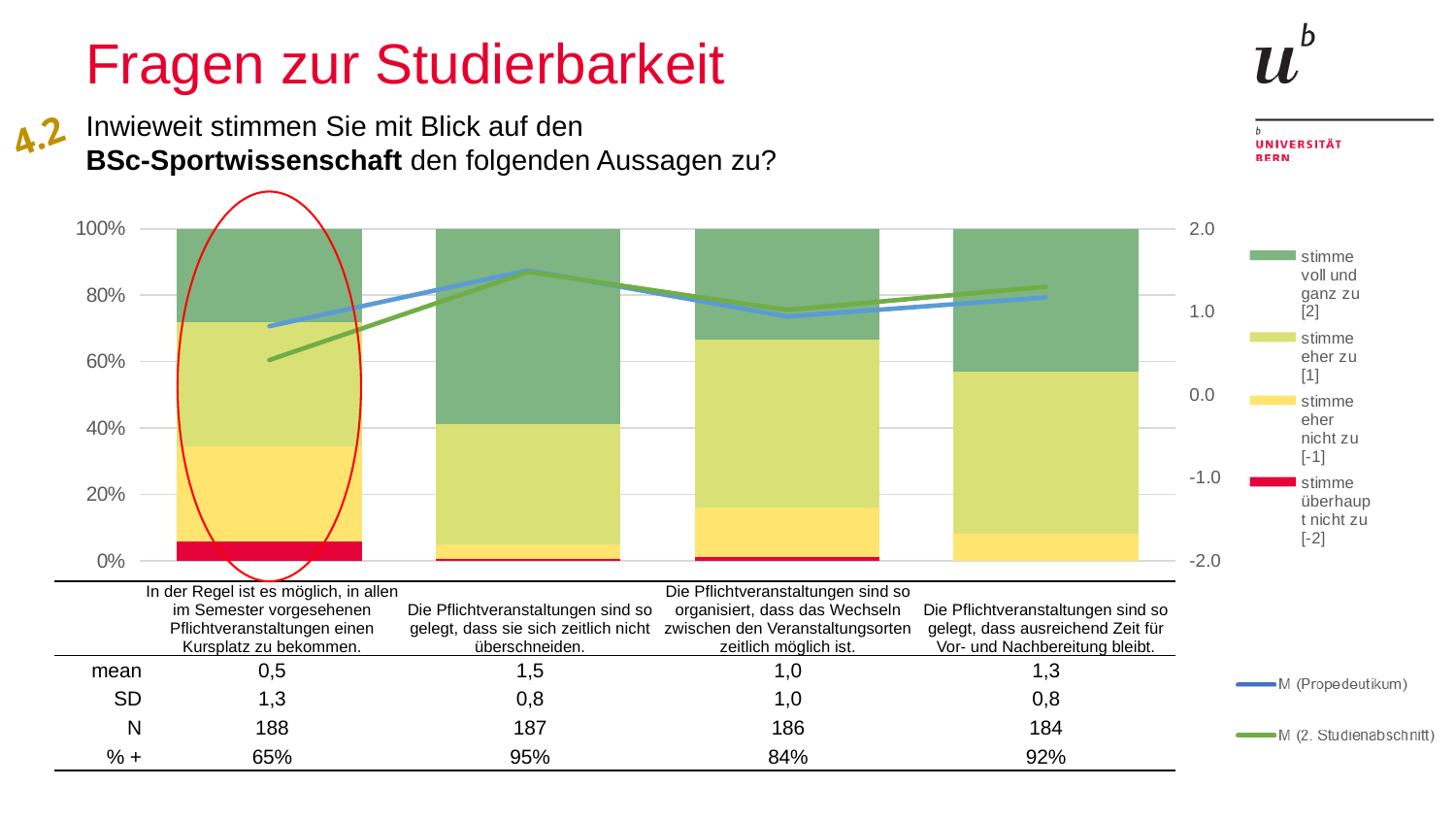
What is the N for the statement "In der Regel ist es möglich, in allen im Semester vorgesehenen Pflichtveranstaltungen einen Kursplatz zu bekommen."? 188 Which statement has the lowest % + value? In der Regel ist es möglich, in allen im Semester vorgesehenen Pflichtveranstaltungen einen Kursplatz zu bekommen. How many series are listed in the legends of the chart in total? 6 How many statements (bars) are shown in the chart? 4 What is the SD for the statement "Die Pflichtveranstaltungen sind so gelegt, dass ausreichend Zeit für Vor- und Nachbereitung bleibt."? 0,8 Which colour represents "stimme überhaupt nicht zu [-2]" in the legend? Red Which statement has the highest mean? Die Pflichtveranstaltungen sind so gelegt, dass sie sich zeitlich nicht überschneiden. What is the difference in % + between the statement about no time overlap (95%) and the statement about getting a course place (65%)? 30% What is the mean for the statement "Die Pflichtveranstaltungen sind so gelegt, dass sie sich zeitlich nicht überschneiden."? 1,5 What kind of chart is shown? Stacked bar chart with line overlays What is the % + value for the statement "Die Pflichtveranstaltungen sind so organisiert, dass das Wechseln zwischen den Veranstaltungsorten zeitlich möglich ist."? 84% Which has the larger SD: the statement about getting a course place or the statement about changing venues? The statement about getting a course place (1,3)